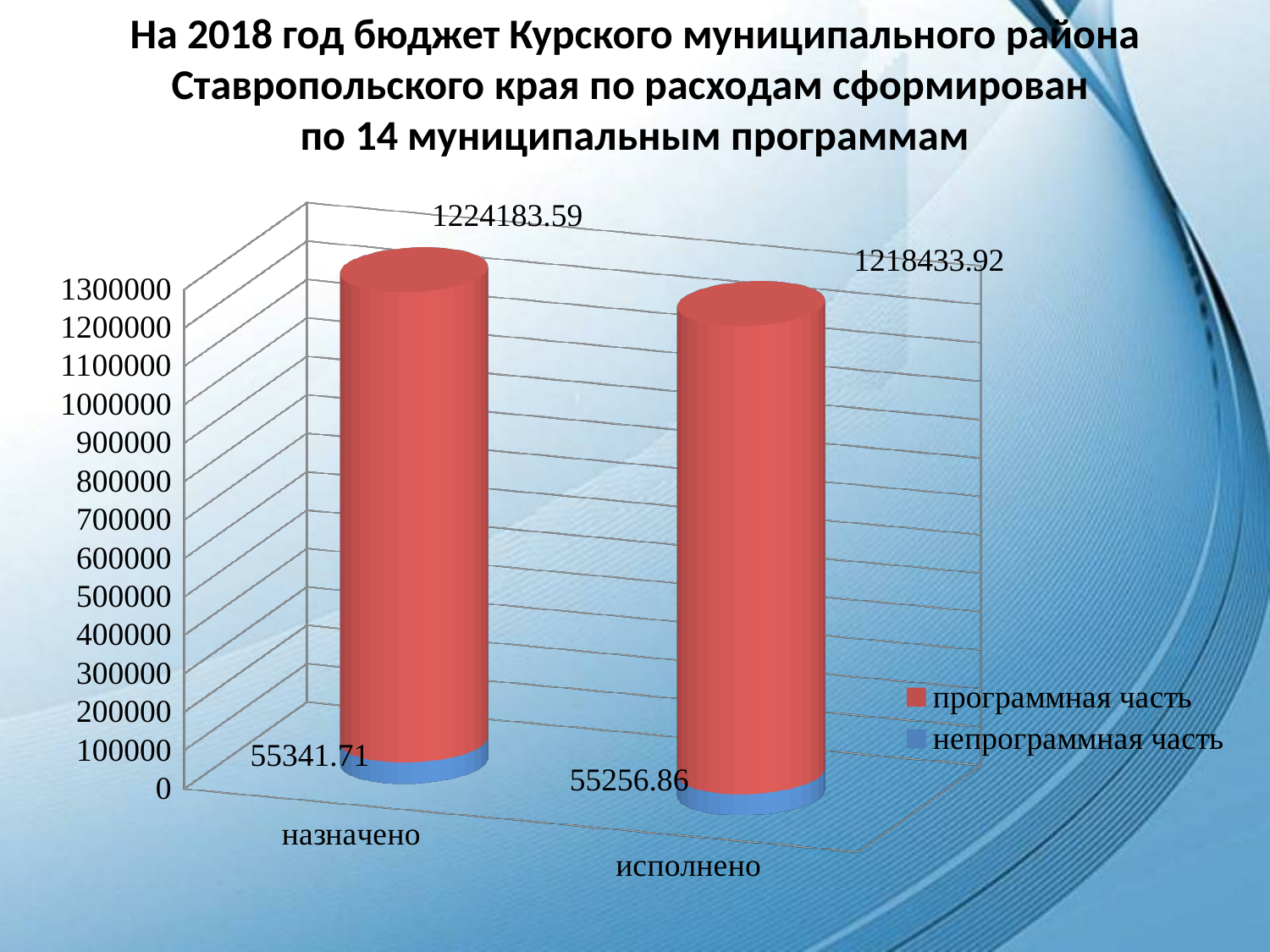
What is the difference between the непрограммная часть values for назначено and исполнено? 84.85 What is the difference between the программная часть values for назначено and исполнено? 5749.67 What is the value of the непрограммная часть series for назначено? 55341.71 What is the total of the stacked bar for исполнено? 1273690.78 What is the total of the stacked bar for назначено? 1279525.30 How many categories are shown on the x axis? 2 How many series does the legend list? 2 What is the value of the программная часть series for назначено? 1224183.59 What kind of chart is shown on the slide? Stacked bar chart Which colour represents the непрограммная часть series? Blue What is the value of the непрограммная часть series for исполнено? 55256.86 What is the value of the программная часть series for исполнено? 1218433.92